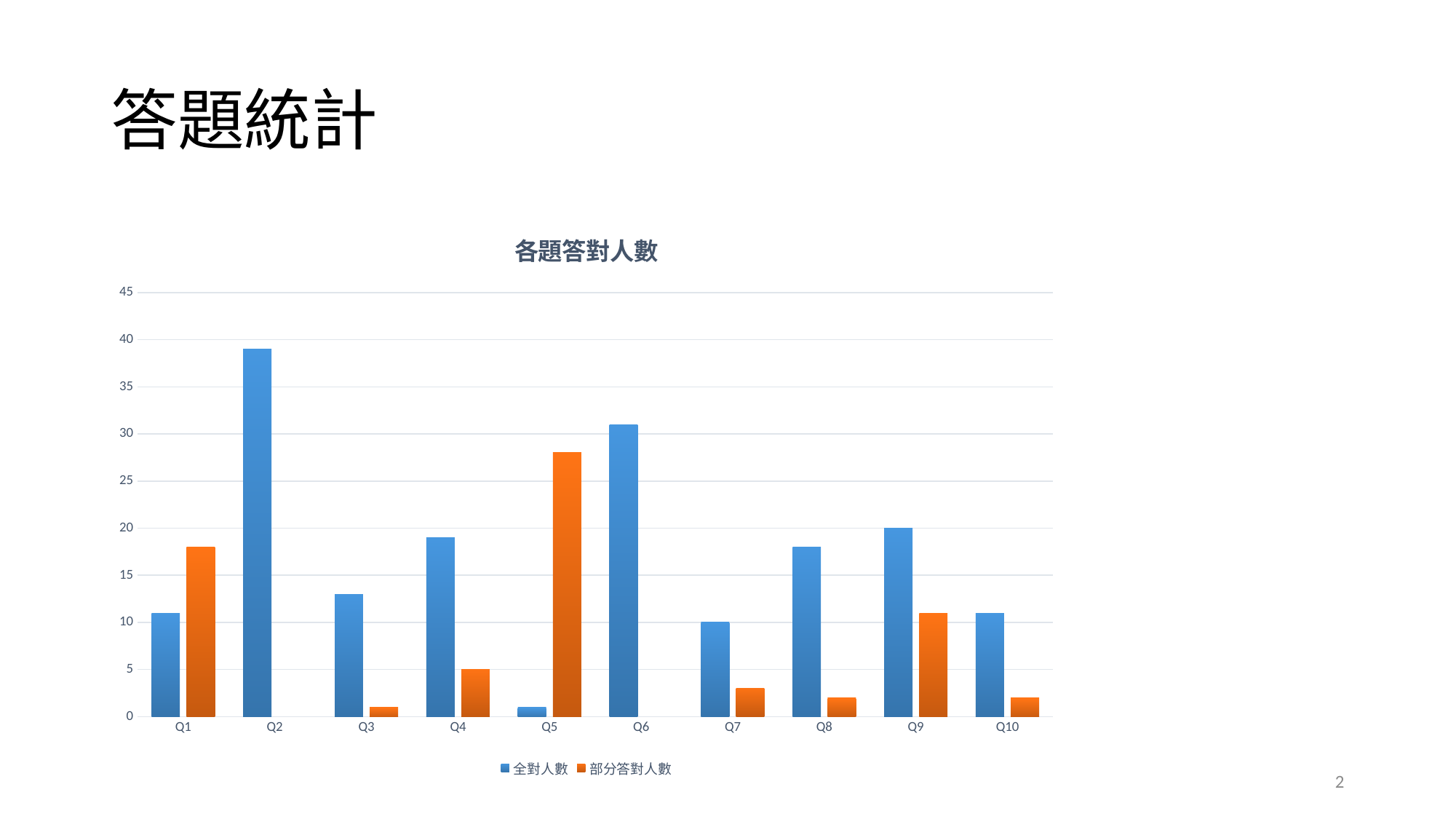
What is the title of the chart? 各題答對人數 Is the 全對人數 for Q2 greater or less than 35? greater How many series does the legend list? 2 Which question has the highest 部分答對人數? Q5 How many questions (categories) are shown on the x axis of the chart? 10 Which has a larger 全對人數: Q4 or Q6? Q6 Which question has the highest 全對人數? Q2 For Q1, which is larger: 全對人數 or 部分答對人數? 部分答對人數 Which question has the lowest 全對人數? Q5 Is the 全對人數 for Q6 greater or less than 35? less What kind of chart is shown on the slide? bar chart Is the 部分答對人數 for Q5 greater or less than 25? greater